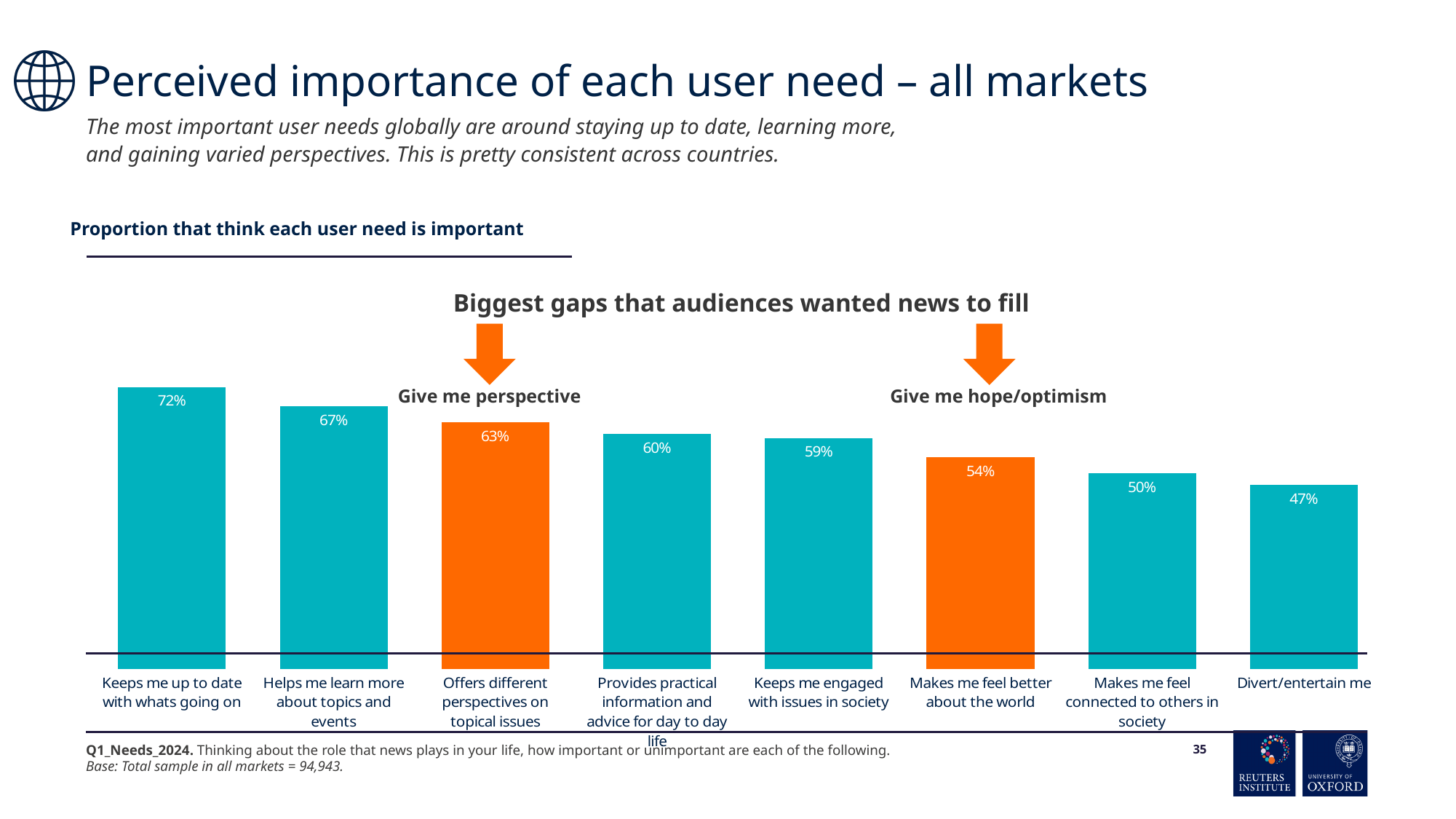
Which user need has the lowest proportion rating it important? Divert/entertain me What is the value for 'Makes me feel better about the world'? 54% What proportion think 'Keeps me up to date with whats going on' is an important user need? 72% Which user need has the highest proportion rating it important? Keeps me up to date with whats going on How many user needs are shown in the chart? 8 What is the value for 'Offers different perspectives on topical issues'? 63% What label is shown above the orange bar for 'Makes me feel better about the world'? Give me hope/optimism Which is larger: 'Provides practical information and advice for day to day life' or 'Keeps me engaged with issues in society'? Provides practical information and advice for day to day life How many bars are highlighted in orange? 2 What is the difference between 'Helps me learn more about topics and events' and 'Makes me feel connected to others in society'? 17 percentage points What kind of chart is shown on the slide? Bar chart Do the values rise or fall from left to right across the chart? Fall